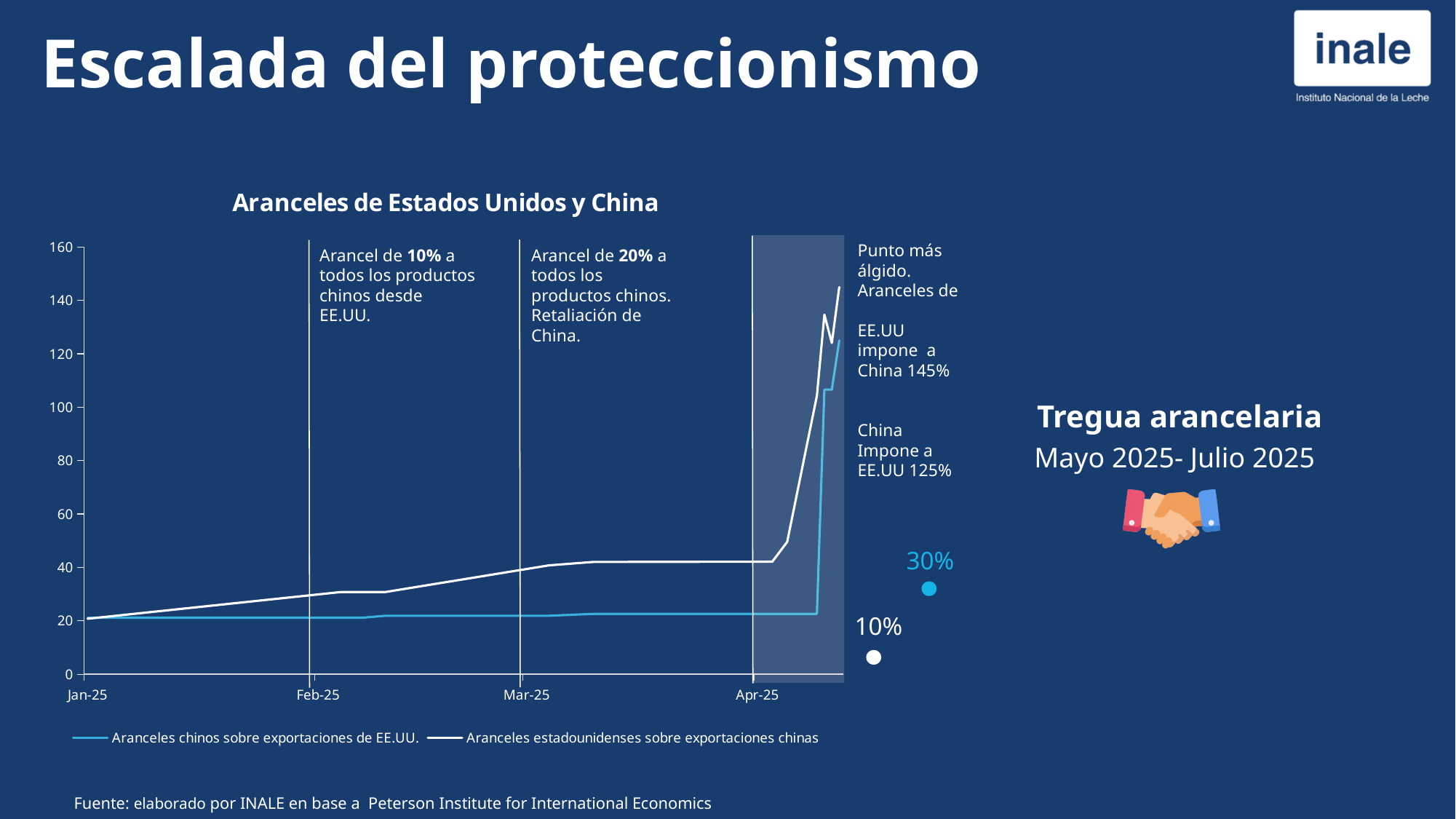
How many series does the chart legend list? 2 What kind of chart is shown on the slide? line chart Is the value of Chinese tariffs on US exports at Mar-25 greater or less than 40? less According to the annotation, what tariff level did the US impose on China at the highest point? 145% According to the annotation, what tariff level did China impose on the US at the highest point? 125% How many month labels are shown on the x axis? 4 Which series is drawn in light blue according to the legend? Aranceles chinos sobre exportaciones de EE.UU. What is the title of the chart? Aranceles de Estados Unidos y China What is the difference between the peak US tariff on China (145%) and the peak Chinese tariff on the US (125%)? 20% At the peak, which series reaches the higher value: US tariffs on Chinese exports or Chinese tariffs on US exports? US tariffs on Chinese exports Do US tariffs on Chinese exports rise or fall from Jan-25 to Apr-25? rise Is the value of US tariffs on Chinese exports at Feb-25 greater or less than 40? less